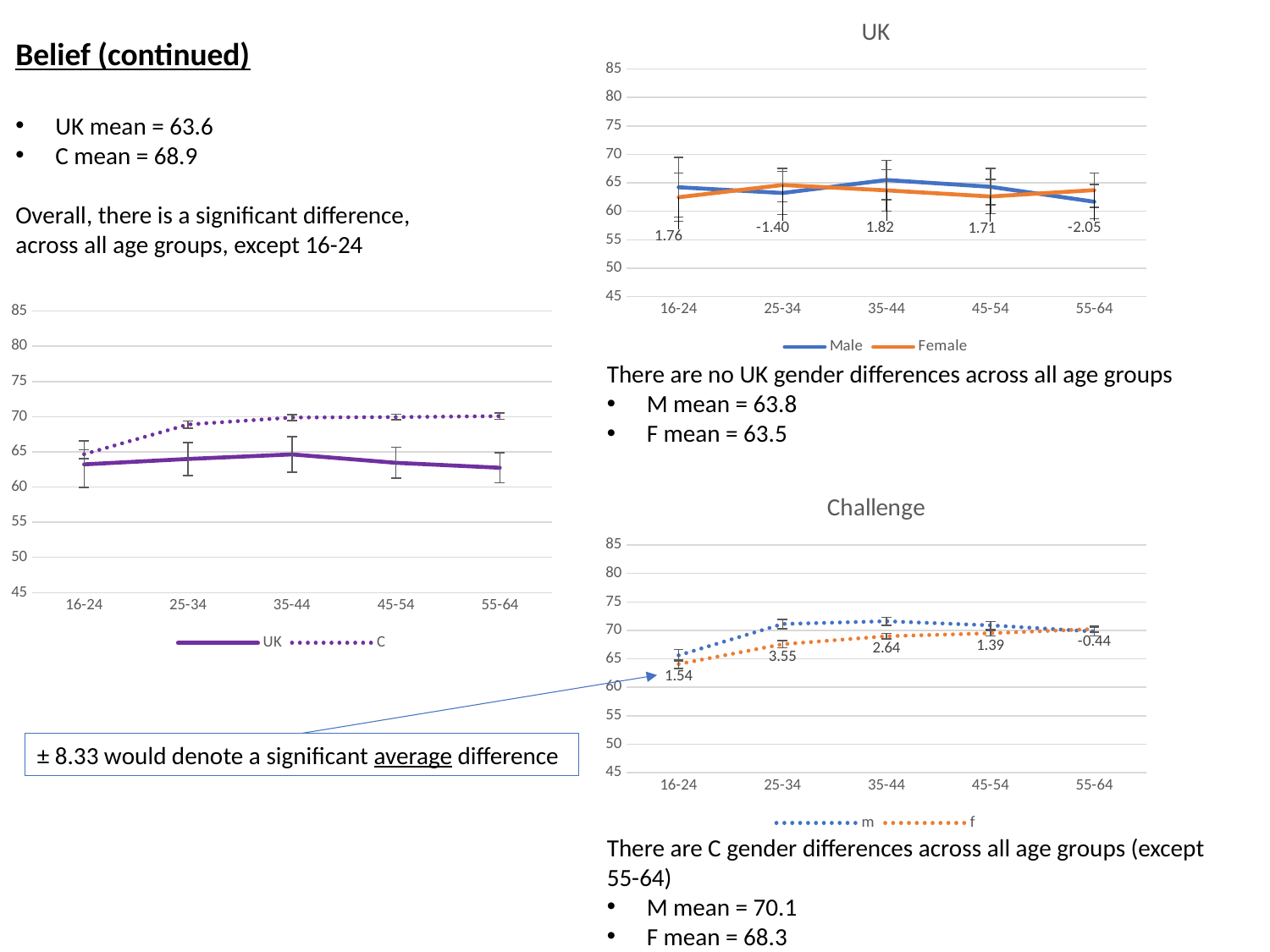
What are the two legend entries of the 'Challenge' chart? m and f In the left chart, is the value of the C series at 35-44 greater or less than 65? greater In the left chart, at 25-34, which series has the larger value, UK or C? C In the 'Challenge' chart, which age group has the lowest printed value? 55-64 How many age groups are shown on the x axis of the 'Challenge' chart? 5 How many series does the legend of the left chart list? 2 In the 'UK' chart, which age group has the lowest printed value? 55-64 In the 'Challenge' chart, which age group has the highest printed value? 25-34 What kind of chart is the chart on the left of the slide? line chart In the 'UK' chart, what value is printed for the 25-34 age group? -1.40 In the 'Challenge' chart, what value is printed for the 25-34 age group? 3.55 In the 'Challenge' chart, is the value of the m series at 16-24 greater or less than 70? less